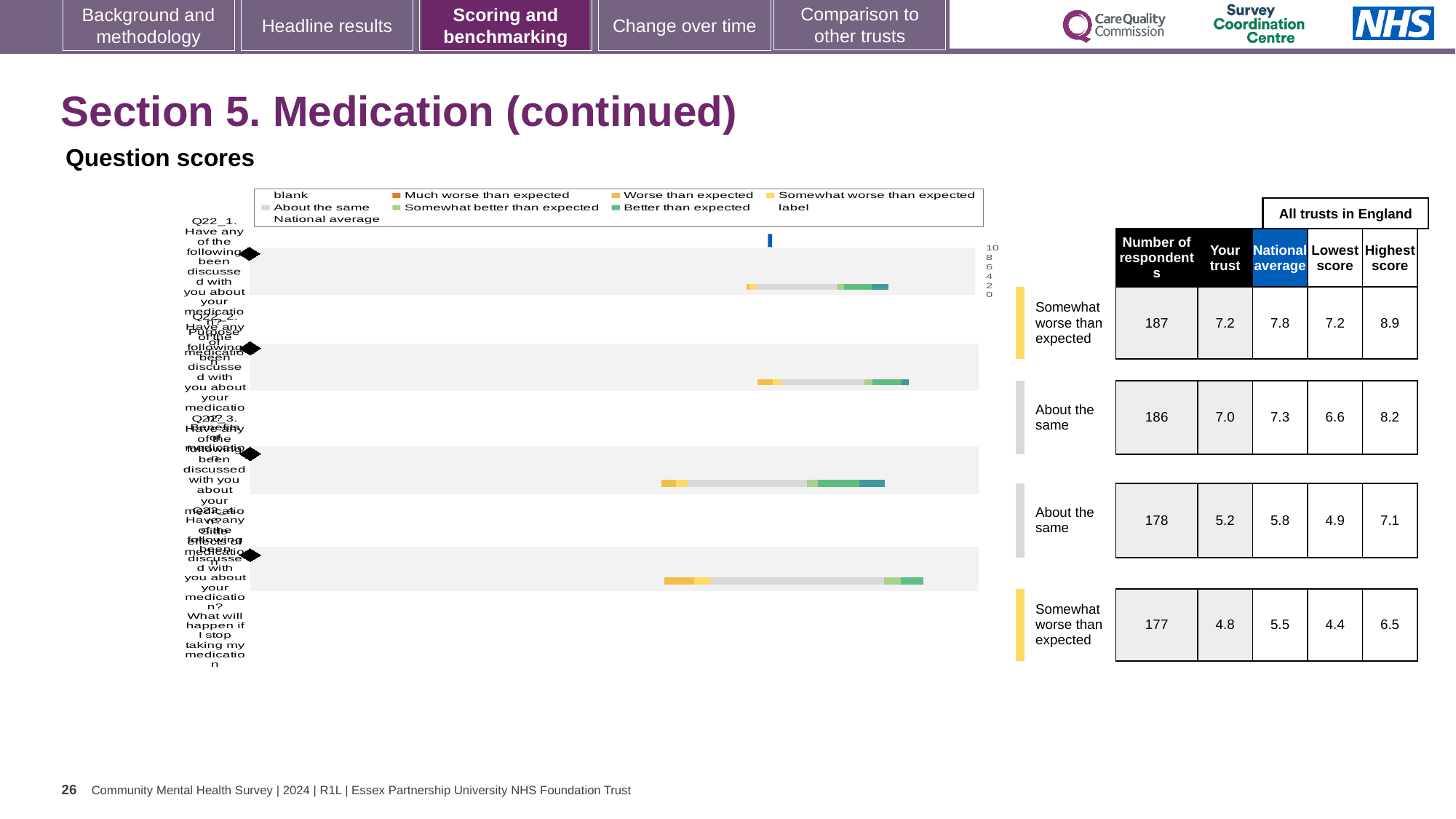
Is the 'Your trust' score for the third question row larger or smaller than its national average? smaller How many question rows (bars) are plotted in the chart? 4 What benchmark category is shown for the first question row (Q22_1)? Somewhat worse than expected What kind of chart is shown under 'Question scores'? bar chart What is the national average for the first question row (Q22_1)? 7.8 What is the difference between the national average and the 'Your trust' score for the first question row (Q22_1)? 0.6 What is the 'Your trust' score for the first question row (Q22_1)? 7.2 What is the highest score across all trusts in England for the second question row? 8.2 Which question row has the lowest 'Your trust' score? the fourth (bottom) row What is the number of respondents for the fourth (bottom) question row? 177 Which question row has the highest 'Your trust' score? the first row (Q22_1) What is the lowest score across all trusts in England for the third question row? 4.9